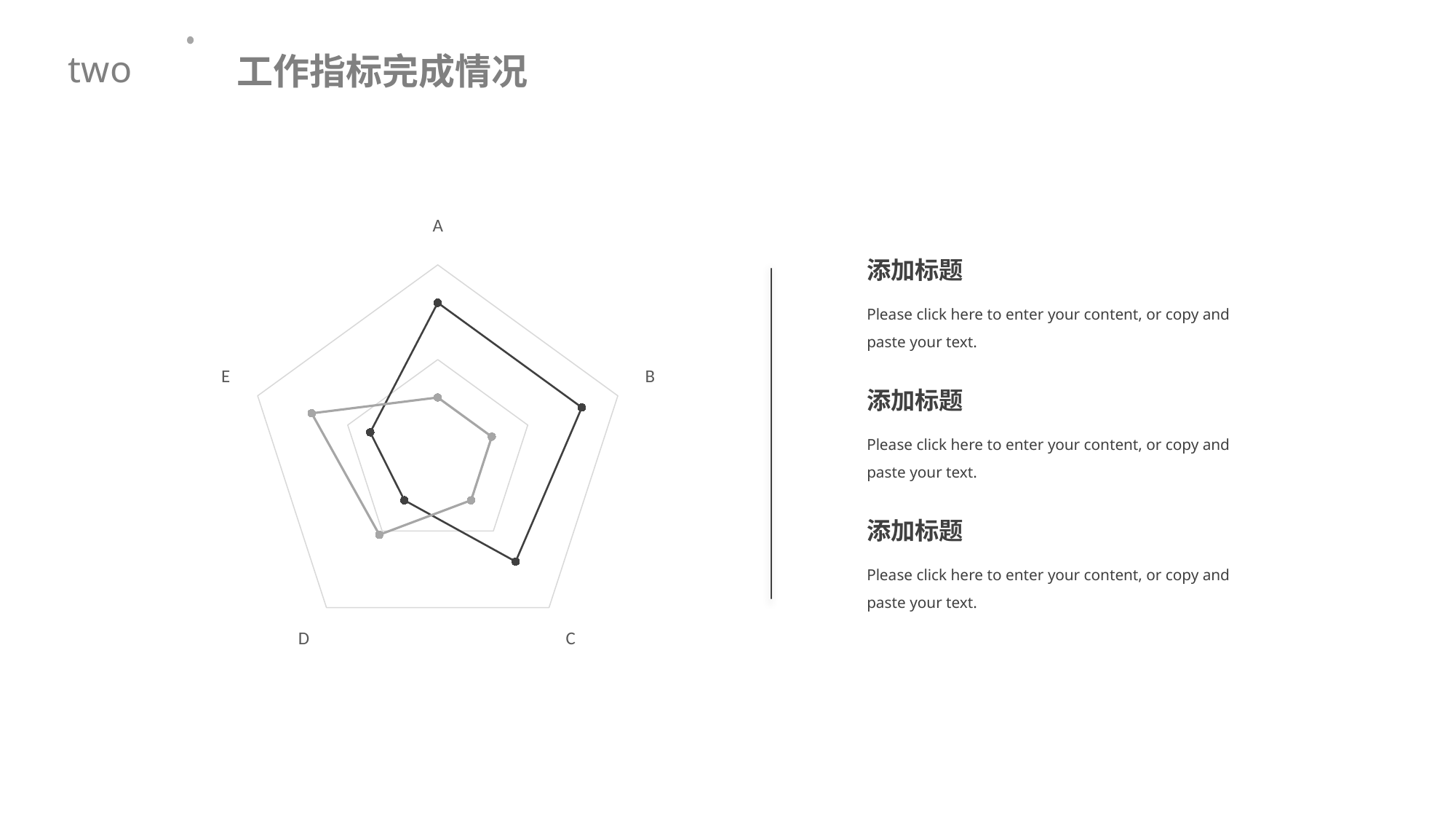
For category B, which series has the larger value, the dark series or the light gray series? the dark series What is the title of the slide containing the radar chart? 工作指标完成情况 In the light gray series, which is larger, the value for E or the value for B? E In the dark series, which is larger, the value for A or the value for D? A How many categories (axes) does the radar chart have? 5 What kind of chart is shown on the slide? radar chart What are the category labels on the radar chart? A, B, C, D, E How many data series are plotted on the radar chart? 2